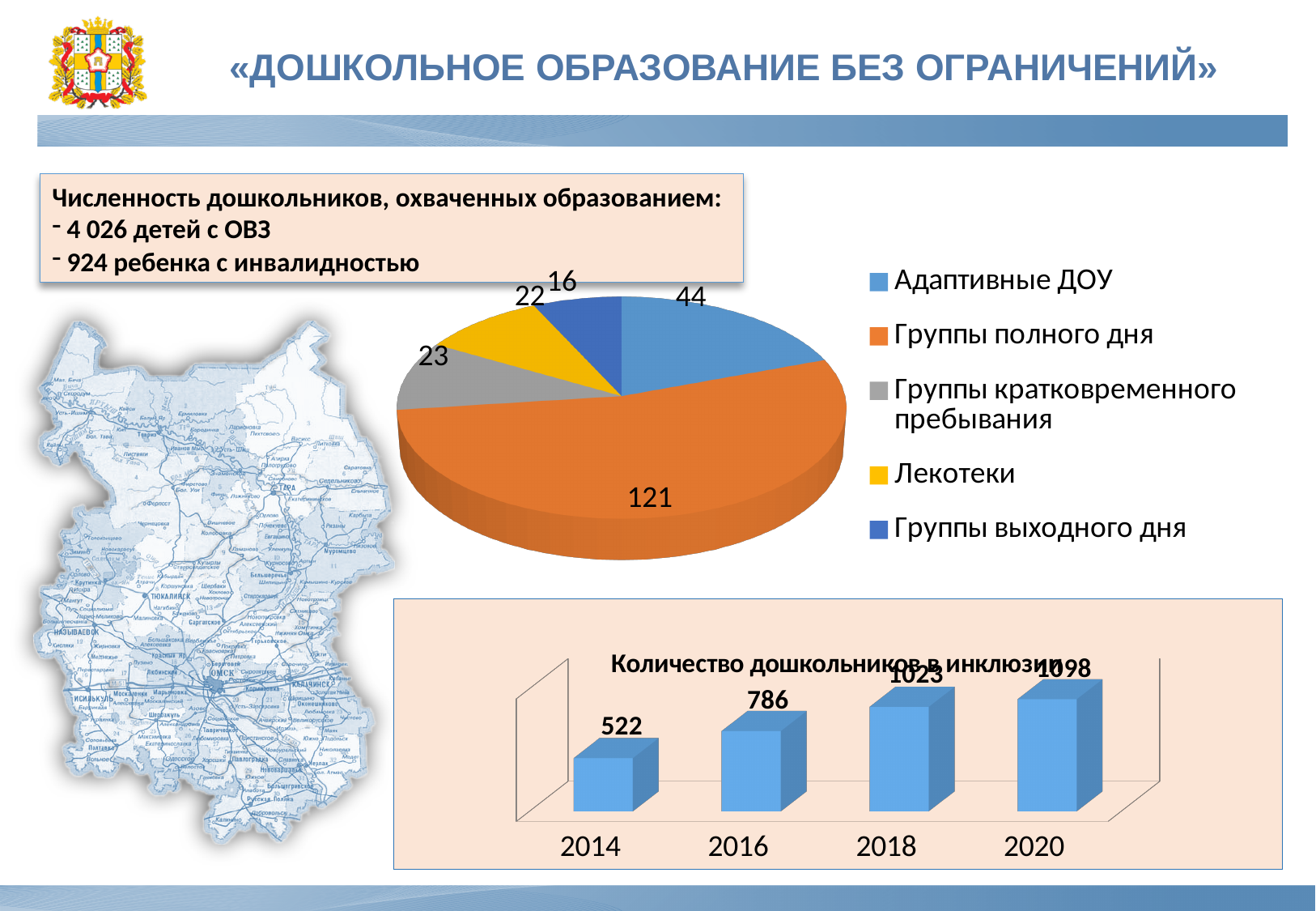
In the chart titled «Количество дошкольников в инклюзии», what is the value for 2016? 786 In the pie chart, what is the value for Адаптивные ДОУ? 44 In the pie chart, which category has the largest value? Группы полного дня In the chart titled «Количество дошкольников в инклюзии», do the values rise or fall from 2014 to 2020? rise In the chart titled «Количество дошкольников в инклюзии», what is the difference between the 2020 and 2014 values? 576 In the pie chart, what is the value for Группы полного дня? 121 In the chart titled «Количество дошкольников в инклюзии», what is the value for 2014? 522 In the chart titled «Количество дошкольников в инклюзии», what kind of chart is it? bar chart In the pie chart, what is the difference between Группы полного дня and Адаптивные ДОУ? 77 In the pie chart, what is the value for Лекотеки? 22 In the pie chart, which category has the smallest value? Группы выходного дня In the pie chart, how many categories does the legend list? 5